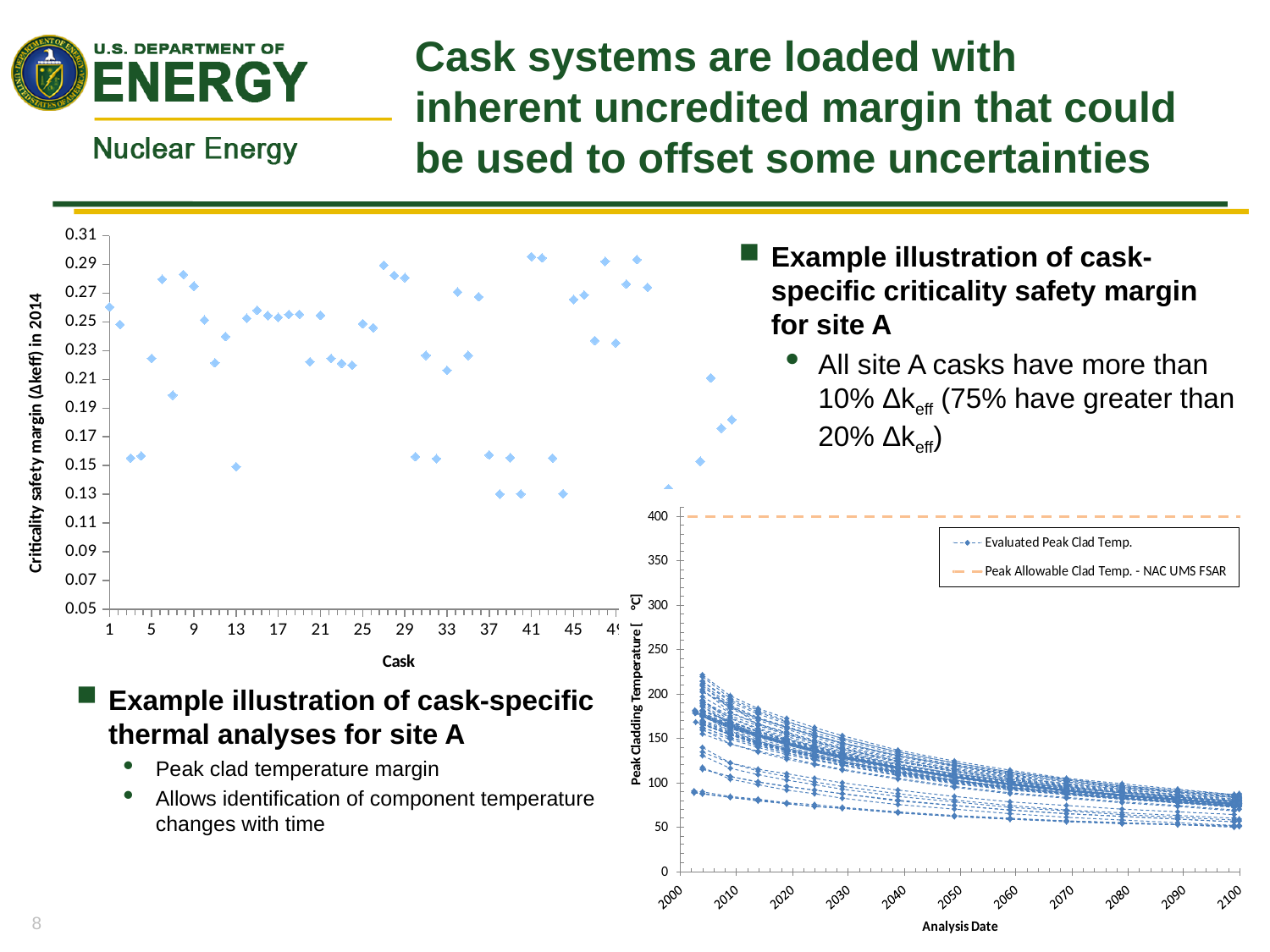
In the Peak Cladding Temperature chart, what are the two legend entries? Evaluated Peak Clad Temp.; Peak Allowable Clad Temp. - NAC UMS FSAR What kind of chart is the chart on the lower right with the y-axis 'Peak Cladding Temperature [°C]'? line chart In the Peak Cladding Temperature chart, do the Evaluated Peak Clad Temp. values rise or fall from 2000 to 2100? fall In the Criticality safety margin chart, is the value for cask 13 greater or less than 0.19? less What is the x-axis title of the Peak Cladding Temperature chart? Analysis Date In the Peak Cladding Temperature chart, is the highest Evaluated Peak Clad Temp. value at the start of the series greater or less than 200? greater In the Peak Cladding Temperature chart, how many series does the legend list? 2 What kind of chart is the chart on the left with the y-axis 'Criticality safety margin (Δkeff) in 2014'? scatter chart In the Peak Cladding Temperature chart, are the Evaluated Peak Clad Temp. values at 2100 greater or less than 100? less In the Peak Cladding Temperature chart, at what temperature does the Peak Allowable Clad Temp. - NAC UMS FSAR line sit? 400